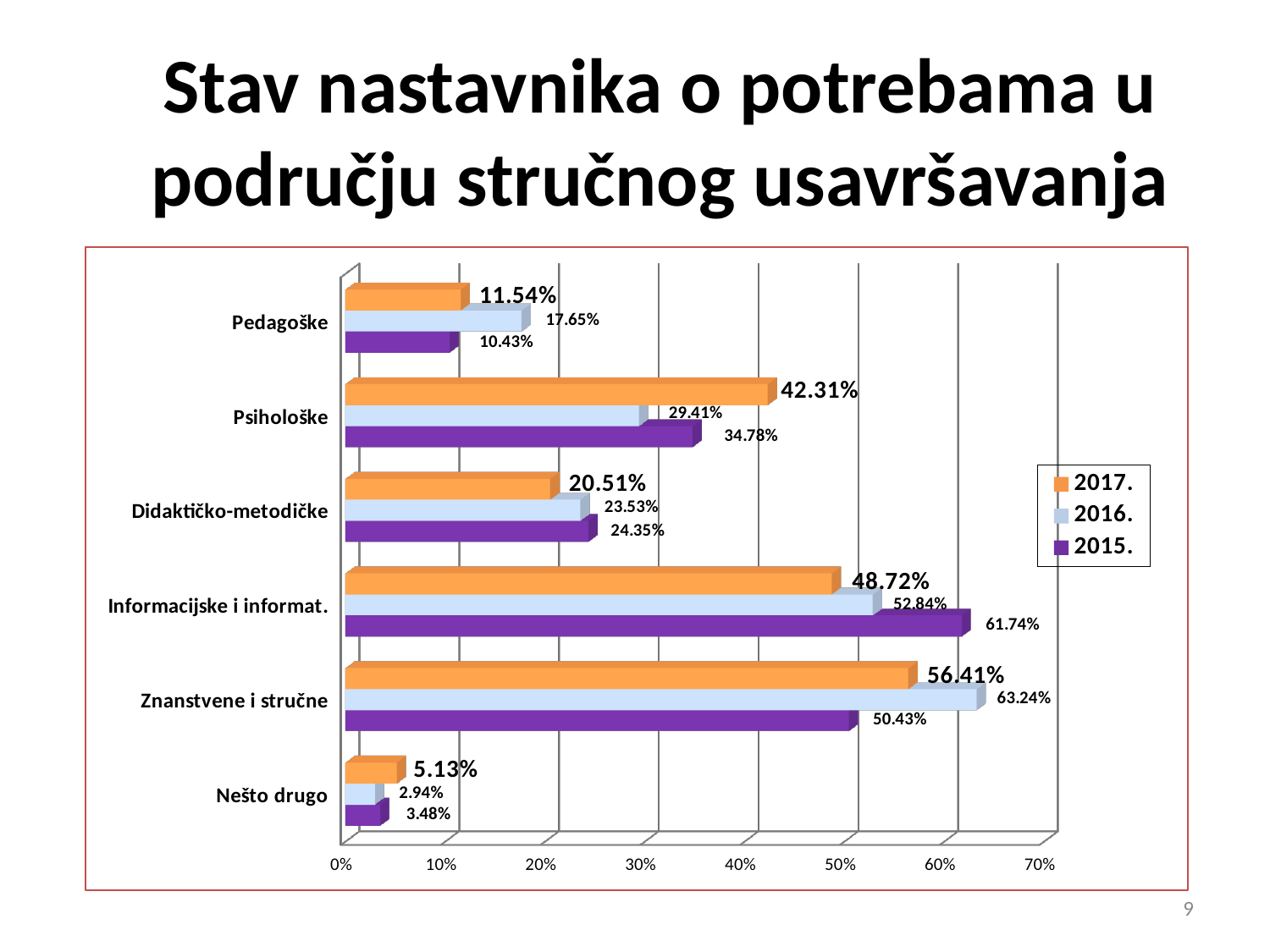
Which is larger for Pedagoške: the 2016. value or the 2015. value? 2016. What is the value for Informacijske i informat. in the 2015. series? 61.74% What kind of chart is shown on the slide? bar chart How many categories are shown on the chart? 6 What is the difference between the 2016. and 2015. values for Znanstvene i stručne? 12.81% Which category has the lowest value in the 2015. series? Nešto drugo Which colour represents the 2017. series in the legend? orange Is the 2015. value for Informacijske i informat. greater or less than 60%? greater What is the value for Nešto drugo in the 2016. series? 2.94% Which category has the highest value in the 2017. series? Znanstvene i stručne What is the value for Psihološke in the 2017. series? 42.31% How many series does the legend list? 3